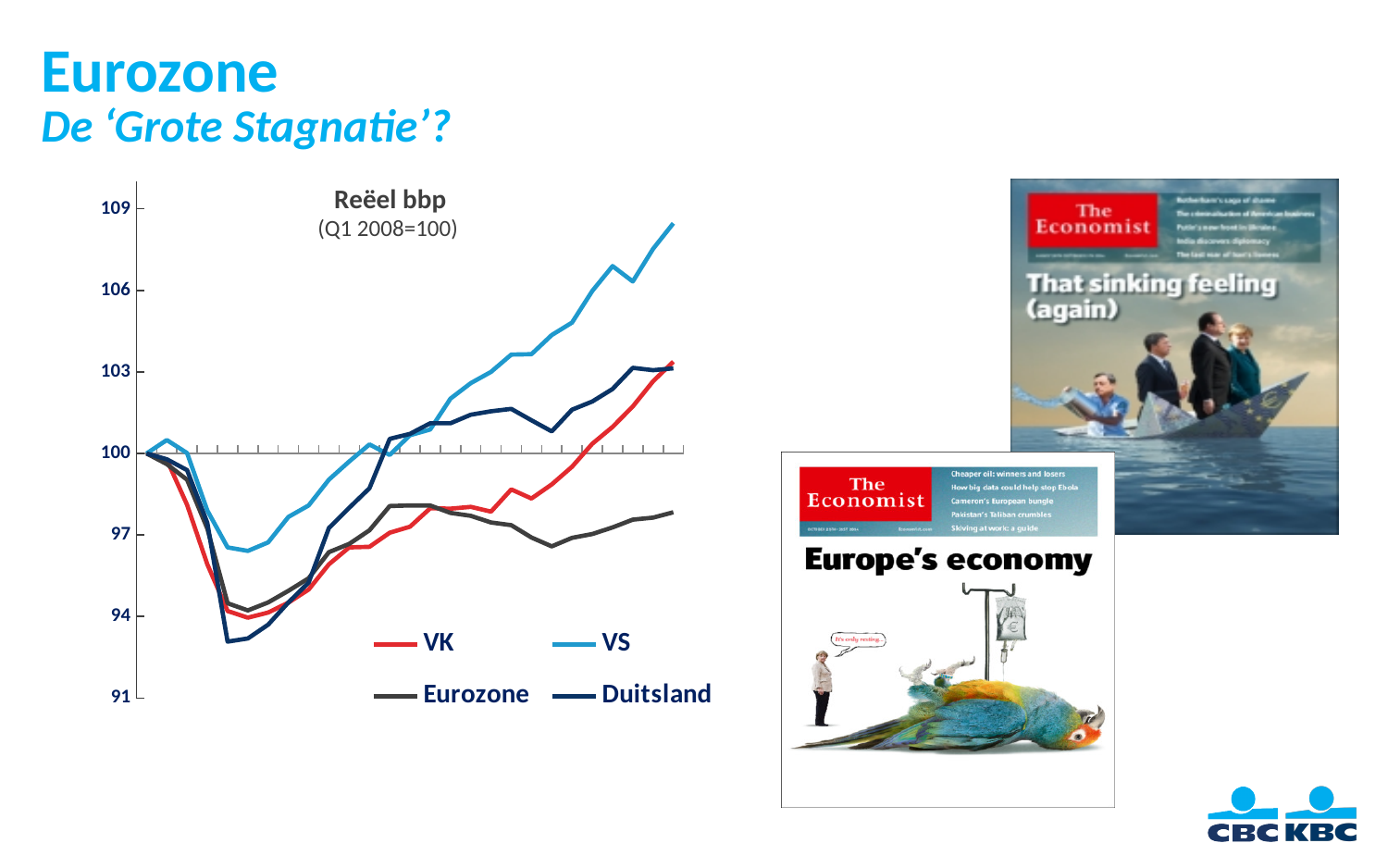
Is the final value of the Eurozone series greater or less than 100? less At what value do all four series start at the left of the chart? 100 Which series ends at the lowest value at the right end of the chart? Eurozone Is the lowest point of the Duitsland series greater or less than 94? less Is the final value of the VS series greater or less than 106? greater Which series ends at the highest value at the right end of the chart? VS Which series are listed in the legend of the chart? VK, VS, Eurozone, Duitsland How many series does the legend of the 'Reëel bbp' chart list? 4 What is the title of the chart on the slide? Reëel bbp At the right end of the chart, which is larger: the VS value or the Eurozone value? VS What kind of chart is shown on the slide? line chart Which series reaches the deepest trough in the chart? Duitsland